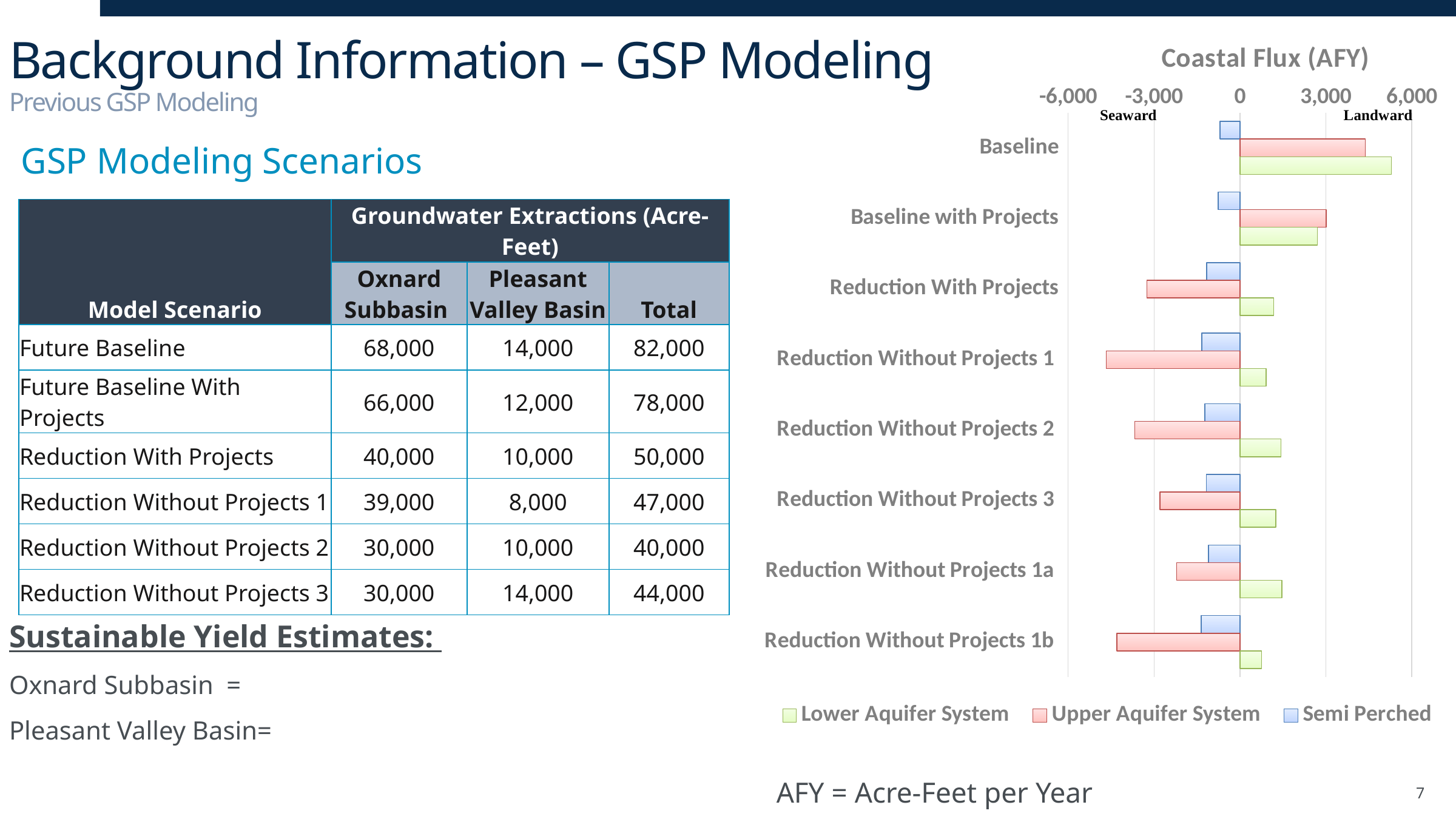
In the Coastal Flux (AFY) chart, is the Lower Aquifer System value for Baseline greater or less than 3,000? greater In the Coastal Flux (AFY) chart, which scenario has the highest Upper Aquifer System value? Baseline In the Coastal Flux (AFY) chart, is the Upper Aquifer System value for Baseline greater or less than 3,000? greater How many series does the legend of the Coastal Flux (AFY) chart list? 3 What kind of chart is the Coastal Flux (AFY) chart? bar chart Which series in the Coastal Flux (AFY) chart is shown in green? Lower Aquifer System In the Coastal Flux (AFY) chart, which scenario has the highest Lower Aquifer System value? Baseline How many model scenarios (categories) are shown on the Coastal Flux (AFY) chart? 8 In the Coastal Flux (AFY) chart, is the Upper Aquifer System value for Reduction Without Projects 1b greater or less than -3,000? less In the Coastal Flux (AFY) chart, which is larger: the Lower Aquifer System value for Baseline or for Baseline with Projects? Baseline In the Coastal Flux (AFY) chart, which is larger: the Upper Aquifer System value for Baseline with Projects or for Reduction With Projects? Baseline with Projects